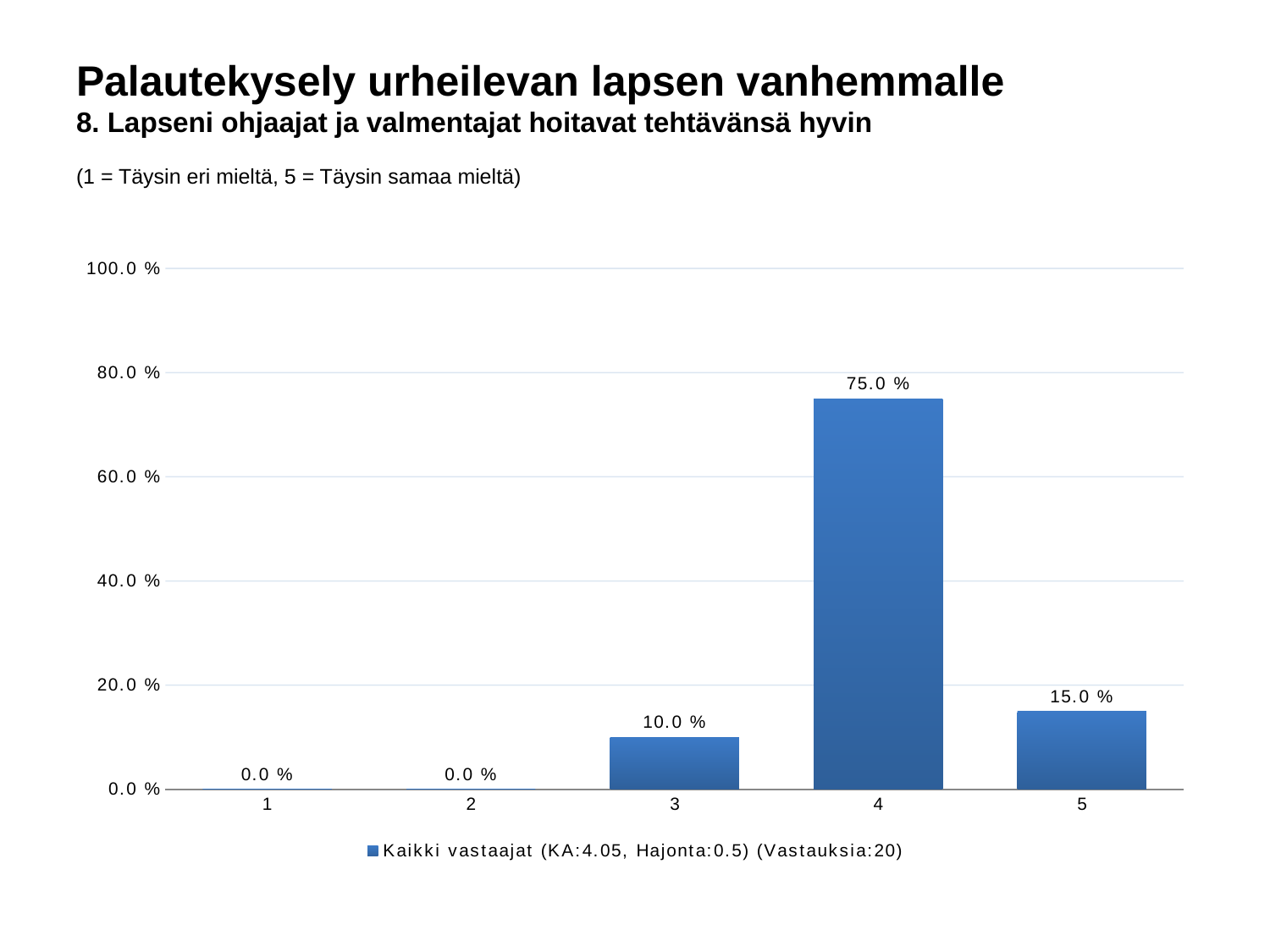
What is the value for category 3? 10.0 % What is the difference between the values for category 4 and category 5? 60.0 % Is the value for category 4 greater or less than 60.0 %? greater How many responses (Vastauksia) does the legend entry report? 20 Which category has the highest value? 4 What kind of chart is shown on the slide? bar chart What is the difference between the values for category 5 and category 3? 5.0 % How many categories are shown on the x axis? 5 What is the value for category 4? 75.0 % What is the value for category 1? 0.0 % Which is larger, the value for category 3 or the value for category 5? 5 What is the value for category 5? 15.0 %